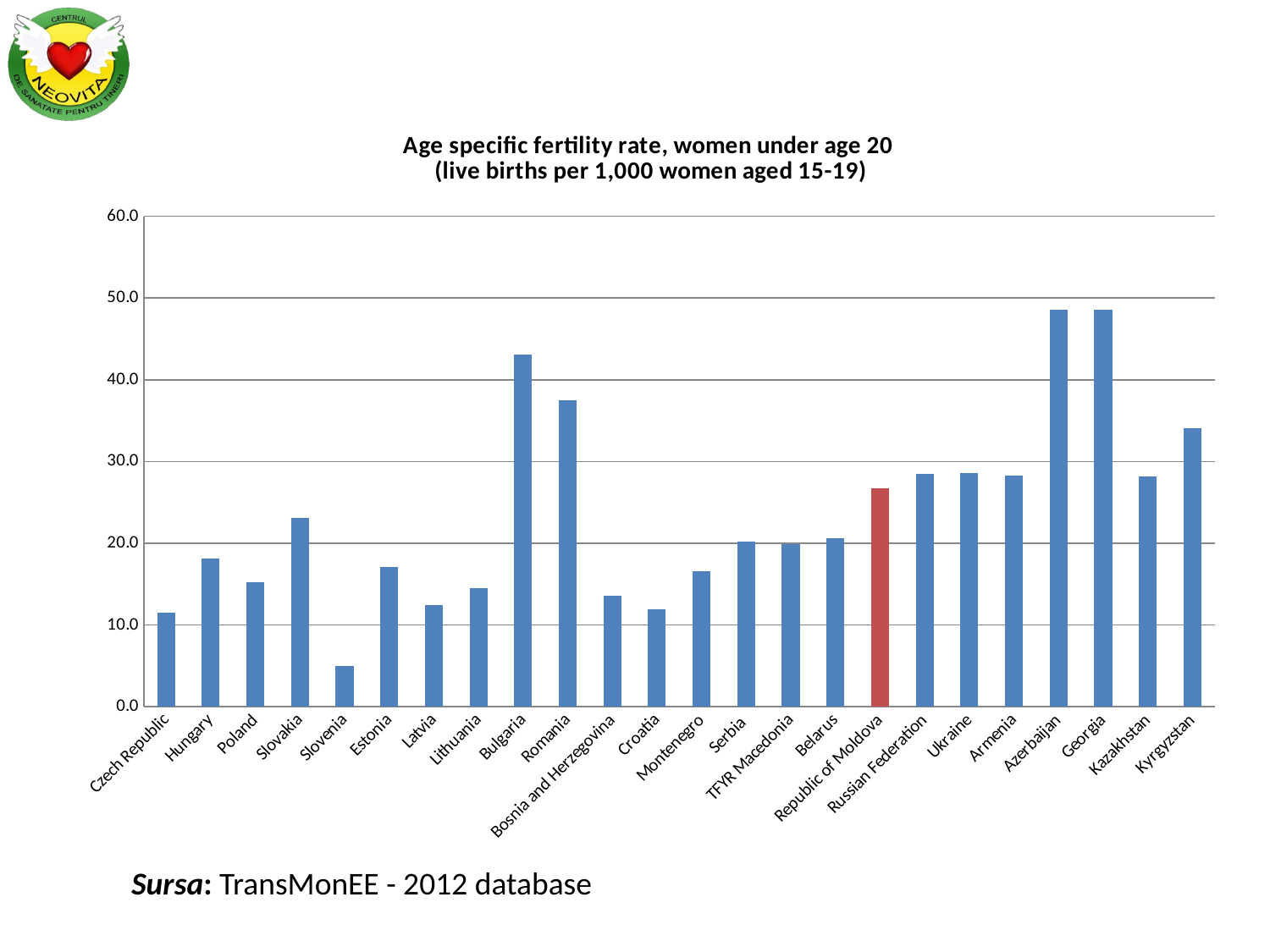
Is the value for Bulgaria greater or less than 40? greater What is the title of the chart? Age specific fertility rate, women under age 20 (live births per 1,000 women aged 15-19) Which country's bar is shown in a different colour (red) from the others? Republic of Moldova Which has a higher value, Bulgaria or Romania? Bulgaria Which has a higher value, Slovakia or Poland? Slovakia Is the value for Slovenia greater or less than 10? less Is the value for Kyrgyzstan greater or less than 30? greater How many countries are shown on the x axis of the chart? 24 Which country has the lowest age specific fertility rate in the chart? Slovenia What kind of chart is shown on the slide? bar chart